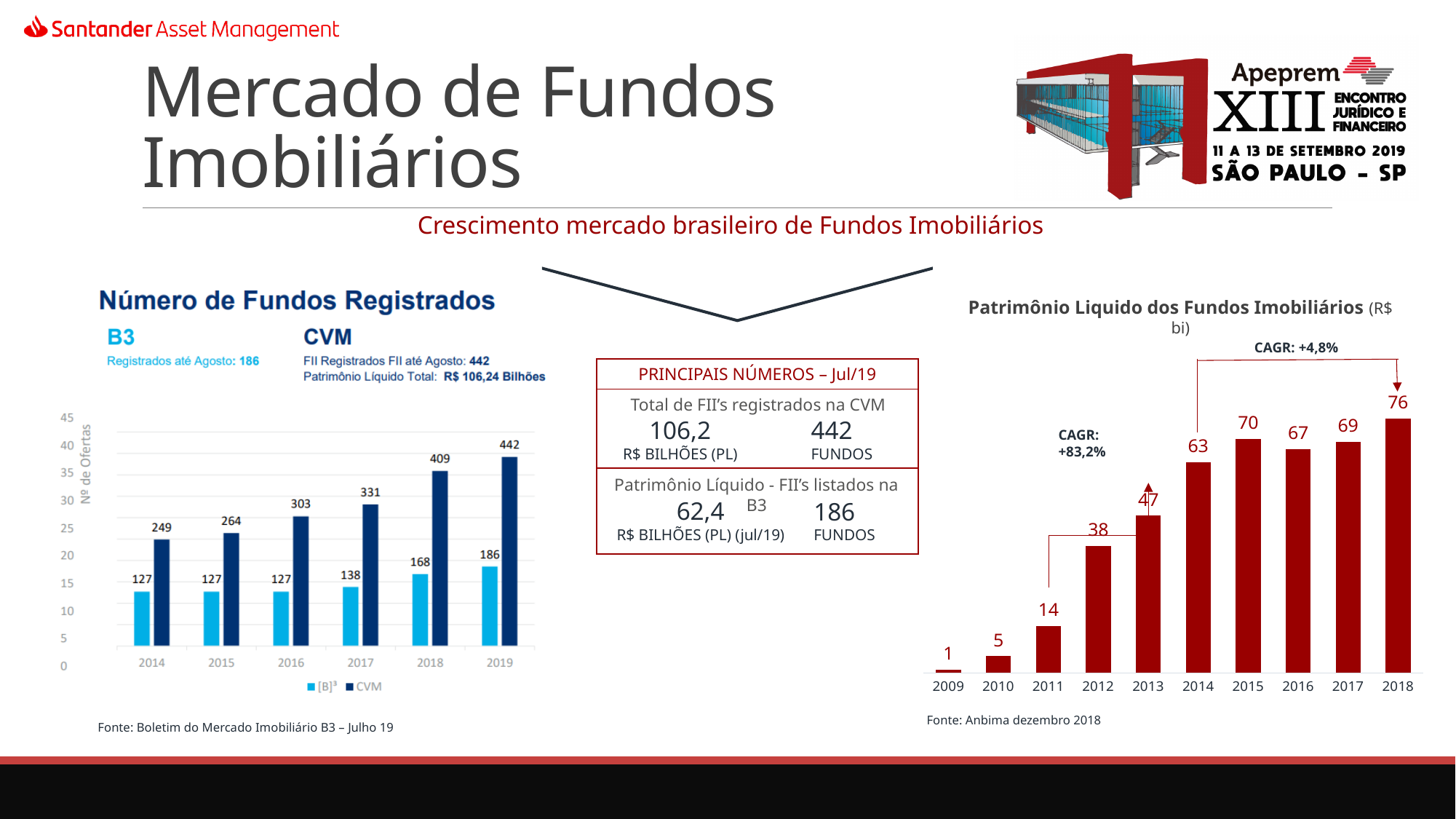
In the 'Patrimônio Liquido dos Fundos Imobiliários' chart, what is the difference between the values for 2018 and 2013? 29 In the 'Patrimônio Liquido dos Fundos Imobiliários' chart, which is larger, the value for 2015 or the value for 2016? 2015 In the 'Número de Fundos Registrados' chart, what is the B3 value for 2017? 138 In the 'Número de Fundos Registrados' chart, what is the CVM value for 2019? 442 In the 'Patrimônio Liquido dos Fundos Imobiliários' chart, which year has the lowest value? 2009 In the 'Número de Fundos Registrados' chart, which year has the highest CVM value? 2019 What kind of chart is the 'Patrimônio Liquido dos Fundos Imobiliários' chart? Bar chart In the 'Patrimônio Liquido dos Fundos Imobiliários' chart, what is the value for 2014? 63 In the 'Número de Fundos Registrados' chart, what is the difference between the CVM and B3 values for 2018? 241 In the 'Número de Fundos Registrados' chart, how many series does the legend list? 2 In the 'Patrimônio Liquido dos Fundos Imobiliários' chart, what CAGR is shown for the period from 2014 to 2018? +4,8% In the 'Número de Fundos Registrados' chart, how many years are shown on the x axis? 6